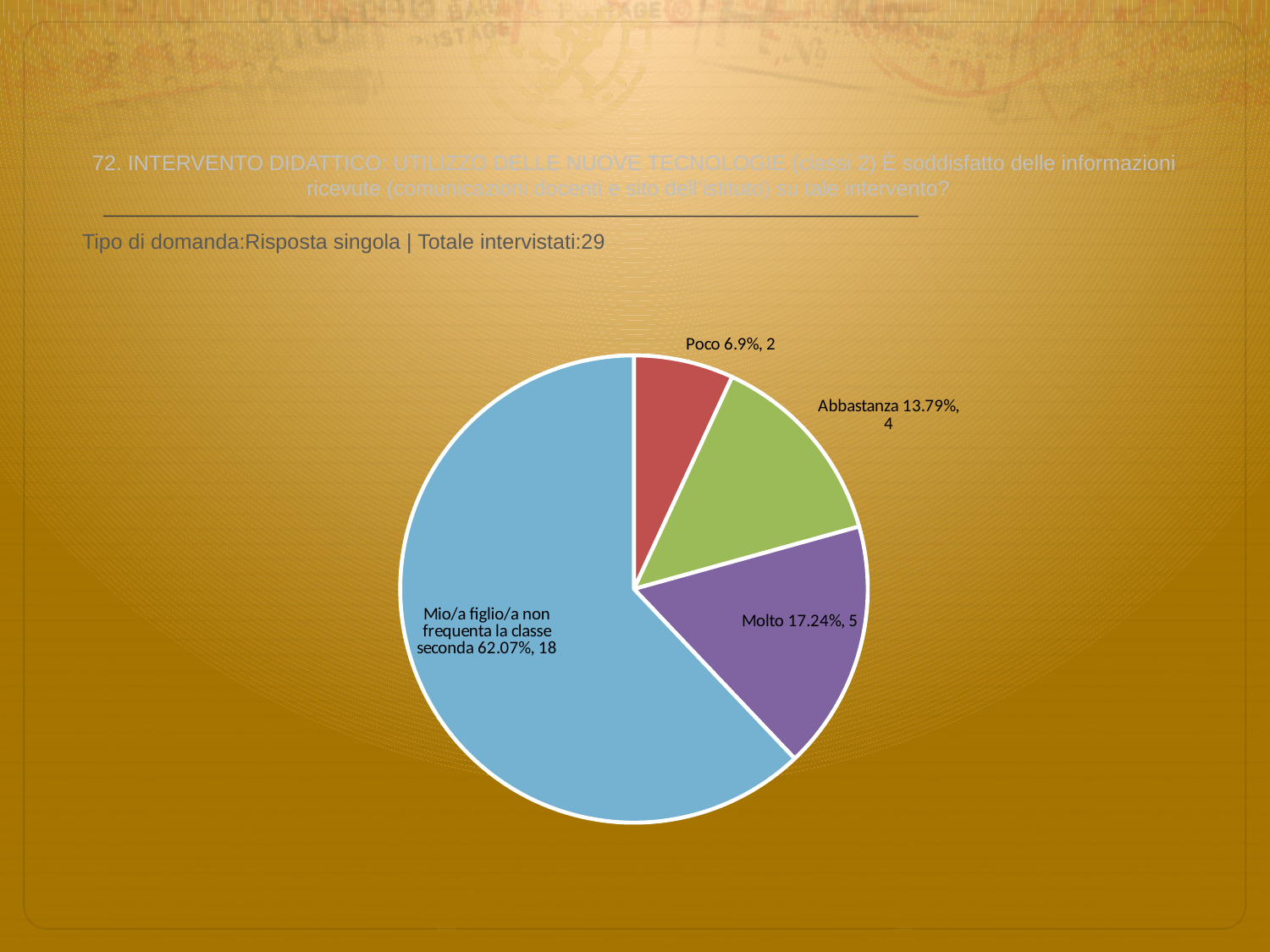
Which has more respondents, 'Abbastanza' or 'Molto'? Molto What is the difference in count between 'Molto' and 'Poco'? 3 What percentage share does the 'Molto' slice have? 17.24% What kind of chart is shown on the slide? pie chart What percentage share does the 'Mio/a figlio/a non frequenta la classe seconda' slice have? 62.07% How many slices does the pie chart have? 4 What percentage share does the 'Abbastanza' slice have? 13.79% How many respondents answered 'Molto'? 5 Which category has the smallest slice of the pie? Poco Which category has the largest slice of the pie? Mio/a figlio/a non frequenta la classe seconda How many respondents answered 'Abbastanza'? 4